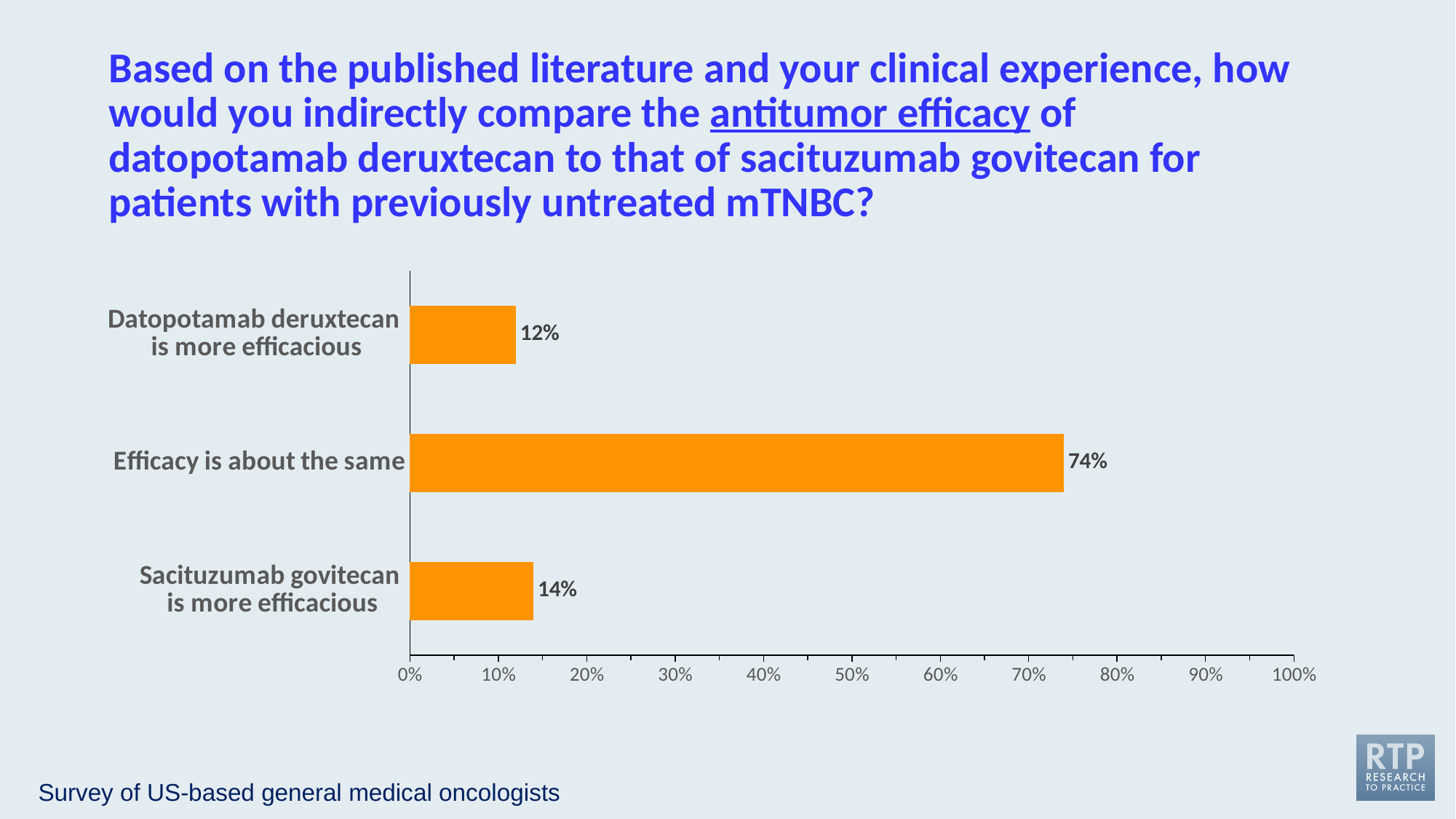
Which response option has the lowest percentage? Datopotamab deruxtecan is more efficacious What is the difference in percentage points between 'Efficacy is about the same' and 'Sacituzumab govitecan is more efficacious'? 60 Which received a larger share of responses: 'Sacituzumab govitecan is more efficacious' or 'Datopotamab deruxtecan is more efficacious'? Sacituzumab govitecan is more efficacious What percentage of respondents said datopotamab deruxtecan is more efficacious? 12% What is the maximum value shown on the x axis? 100% Which response option has the highest percentage? Efficacy is about the same How many response options are shown in the chart? 3 What percentage of respondents said efficacy is about the same? 74% Is the value for 'Efficacy is about the same' greater or less than 70%? greater What type of chart is shown on the slide? Bar chart What is the difference in percentage points between 'Sacituzumab govitecan is more efficacious' and 'Datopotamab deruxtecan is more efficacious'? 2 What percentage of respondents said sacituzumab govitecan is more efficacious? 14%